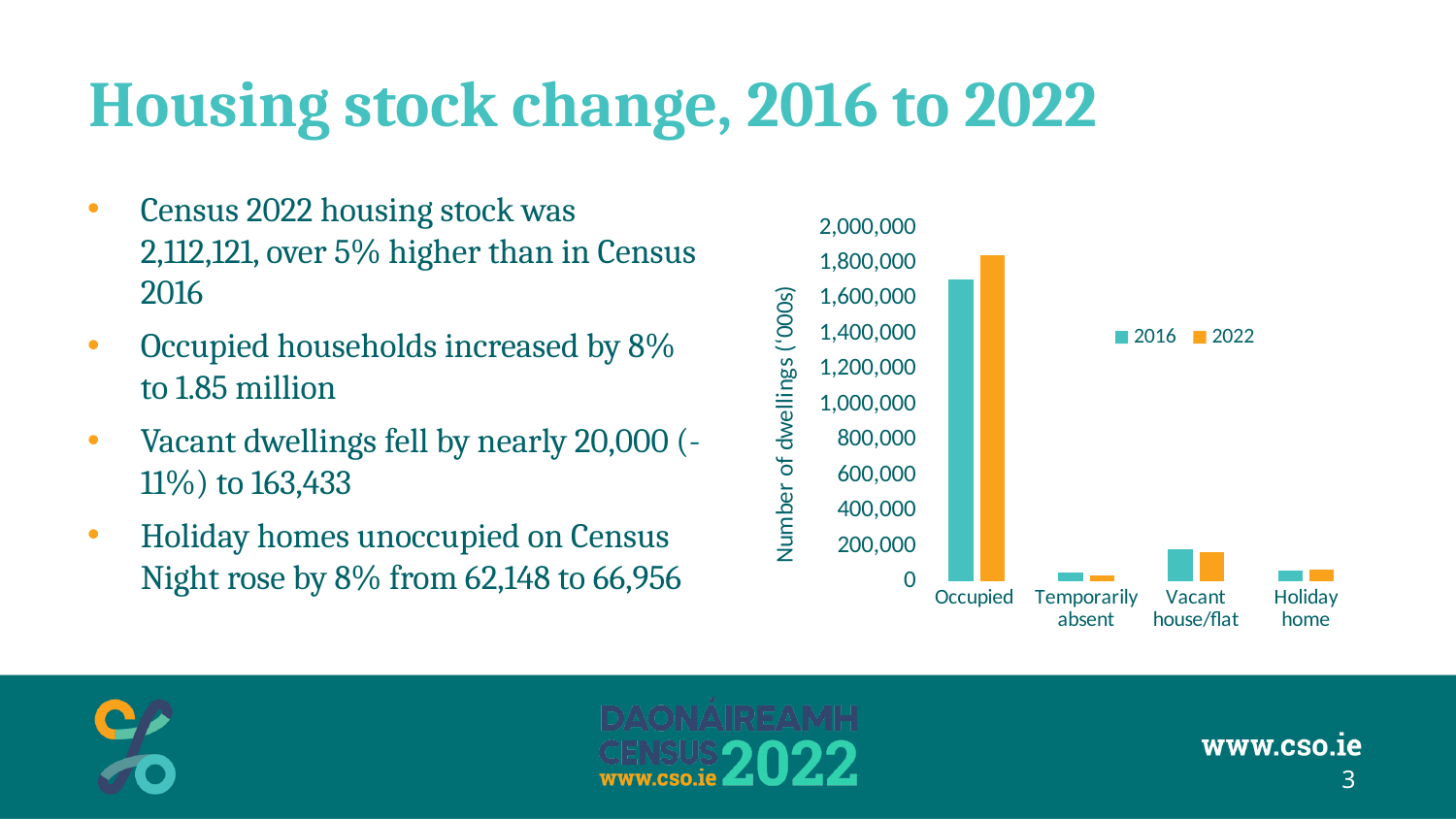
For the Occupied category, which is larger: the 2016 value or the 2022 value? 2022 Which category has the lowest values in the chart? Temporarily absent Which category has the highest values in the chart? Occupied How many series does the chart's legend list? 2 Is the 2016 value for Occupied greater or less than 1,600,000? greater What are the two entries in the chart's legend? 2016 and 2022 How many categories are shown on the x axis of the chart? 4 Is the 2022 value for Occupied greater or less than 1,400,000? greater What is the label on the chart's vertical axis? Number of dwellings ('000s) What kind of chart is shown on the slide? bar chart Is the 2016 value for Vacant house/flat greater or less than 400,000? less